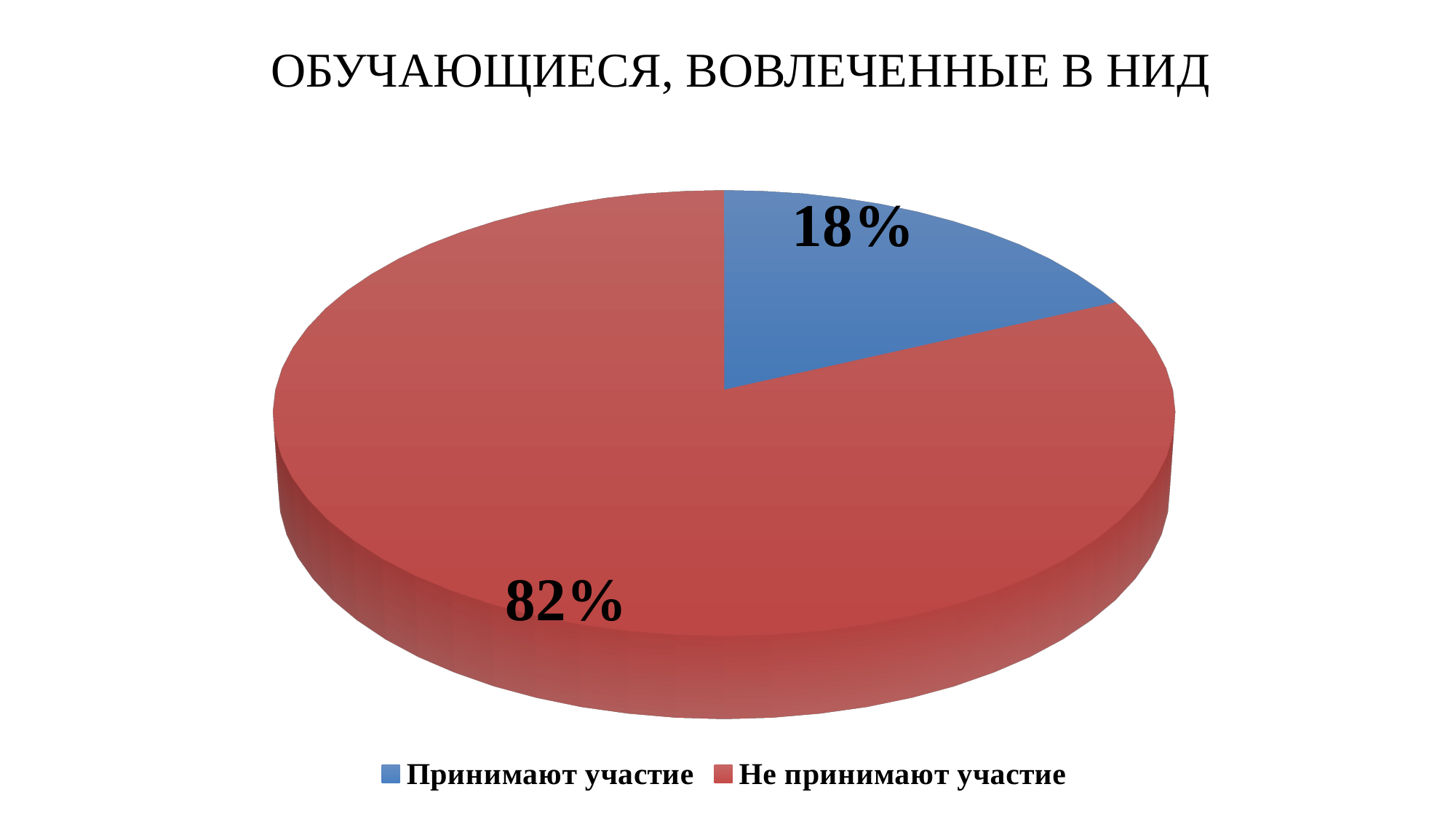
What share of the pie is labelled "Принимают участие"? 18% How many entries does the legend list? 2 What is the title of the chart? ОБУЧАЮЩИЕСЯ, ВОВЛЕЧЕННЫЕ В НИД What is the difference in percentage points between "Не принимают участие" and "Принимают участие"? 64 What colour is the slice for "Принимают участие"? Blue What share of the pie is labelled "Не принимают участие"? 82% Which category has the largest slice of the pie? Не принимают участие What kind of chart is shown on the slide? Pie chart Which category has the smallest slice of the pie? Принимают участие Which is larger: the share for "Принимают участие" or the share for "Не принимают участие"? Не принимают участие How many slices does the pie chart have? 2